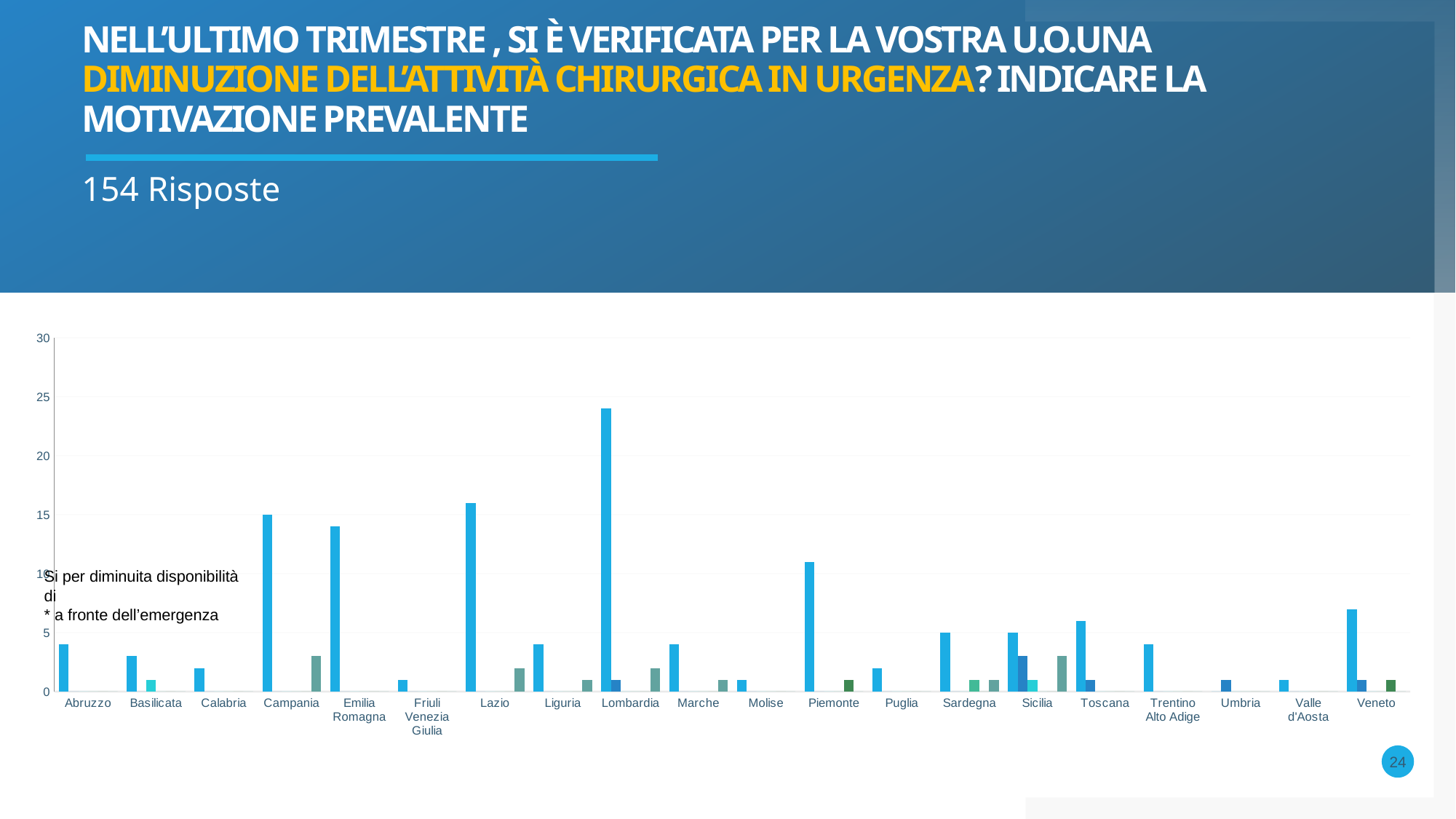
Is the tallest bar for Abruzzo greater or less than 5? less Which region has the taller light blue bar, Emilia Romagna or Piemonte? Emilia Romagna Is the tallest bar for Lazio greater or less than 15? greater What kind of chart is shown on the slide? bar chart Is the tallest bar for Emilia Romagna greater or less than 15? less Which region has the tallest bar in the chart? Lombardia How many responses does the slide say the chart is based on? 154 Risposte Which region has the taller light blue bar, Lombardia or Lazio? Lombardia How many regions are listed along the x axis of the chart? 20